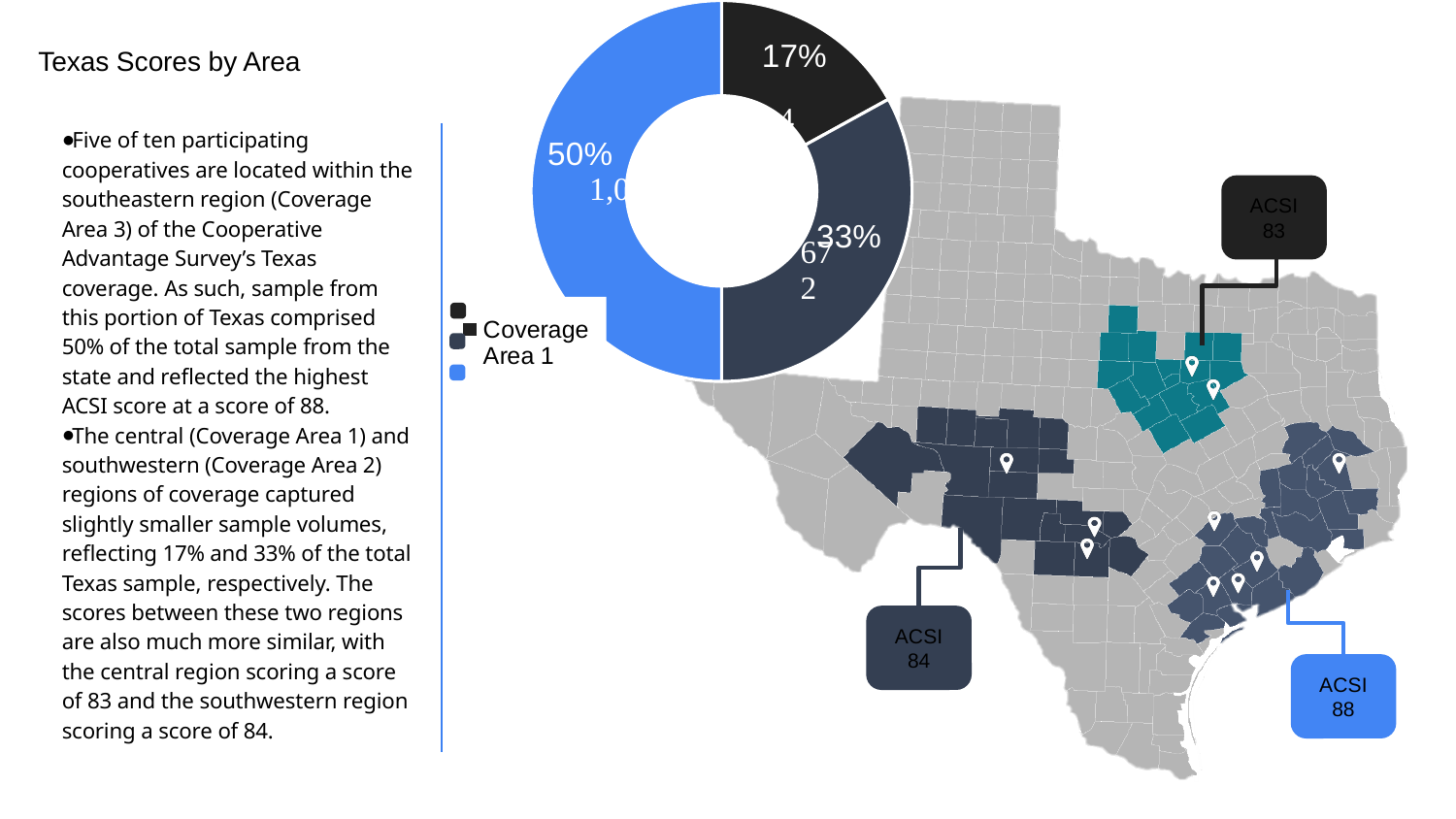
What kind of chart is shown on the slide? Pie (donut) chart What percentage is shown on the dark blue slice of the donut chart? 33% Which is larger in the donut chart, the dark blue slice or the black slice? The dark blue slice How many slices does the donut chart have? 3 What is the difference between the light blue slice and the dark blue slice of the donut chart? 17% What percentage is shown on the light blue slice of the donut chart? 50% Which slice of the donut chart is the largest? The light blue slice (50%) What is the difference between the largest and smallest slices of the donut chart? 33% What is the title of the slide containing the donut chart? Texas Scores by Area Which slice of the donut chart is the smallest? The black slice (17%) What percentage is shown on the black slice of the donut chart? 17% Is the share of the light blue slice in the donut chart greater or less than 40%? greater